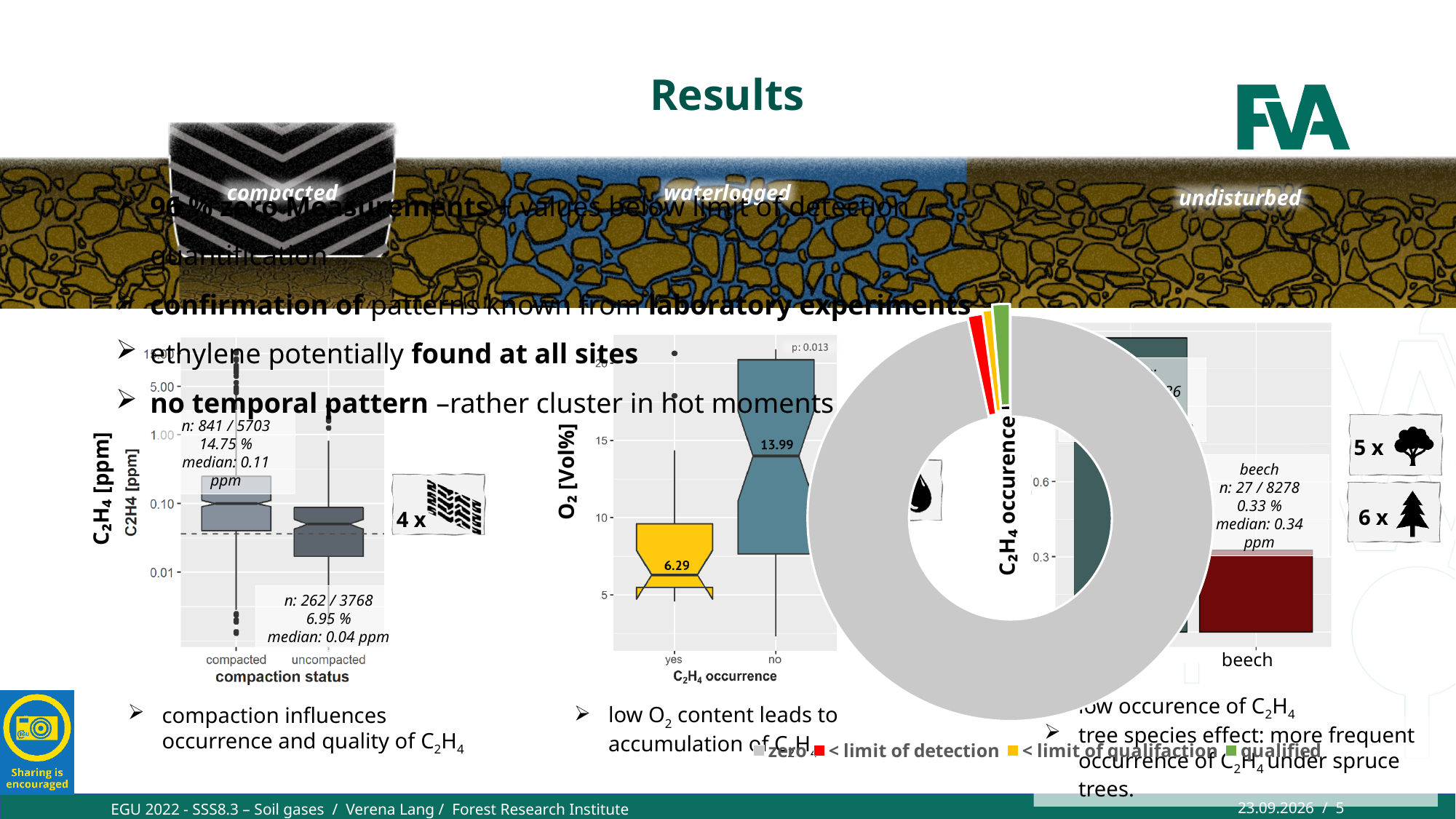
In the O2 [Vol%] box plot, what p-value is printed in the top right corner? p: 0.013 In the O2 [Vol%] box plot, which C2H4 occurrence group has the higher labelled median O2 value, 'yes' or 'no'? no What kind of chart is the O2 [Vol%] versus C2H4 occurrence plot? box plot How many entries does the legend of the donut chart list? 4 In the C2H4 [ppm] box plot by compaction status, what median is given for the compacted group? 0.11 ppm In the C2H4 occurrence bar chart on the right, what percentage is given for beech? 0.33 % In the O2 [Vol%] box plot, what is the labelled median O2 value for the 'yes' C2H4 occurrence group? 6.29 In the O2 [Vol%] box plot, what is the labelled median O2 value for the 'no' C2H4 occurrence group? 13.99 In the O2 [Vol%] box plot, what is the difference between the labelled medians of the 'no' and 'yes' groups? 7.70 In the C2H4 [ppm] box plot by compaction status, what percentage is given for the compacted group? 14.75 % In the C2H4 [ppm] box plot by compaction status, how many compaction status categories are shown on the x axis? 2 In the C2H4 [ppm] box plot by compaction status, what median is given for the uncompacted group? 0.04 ppm